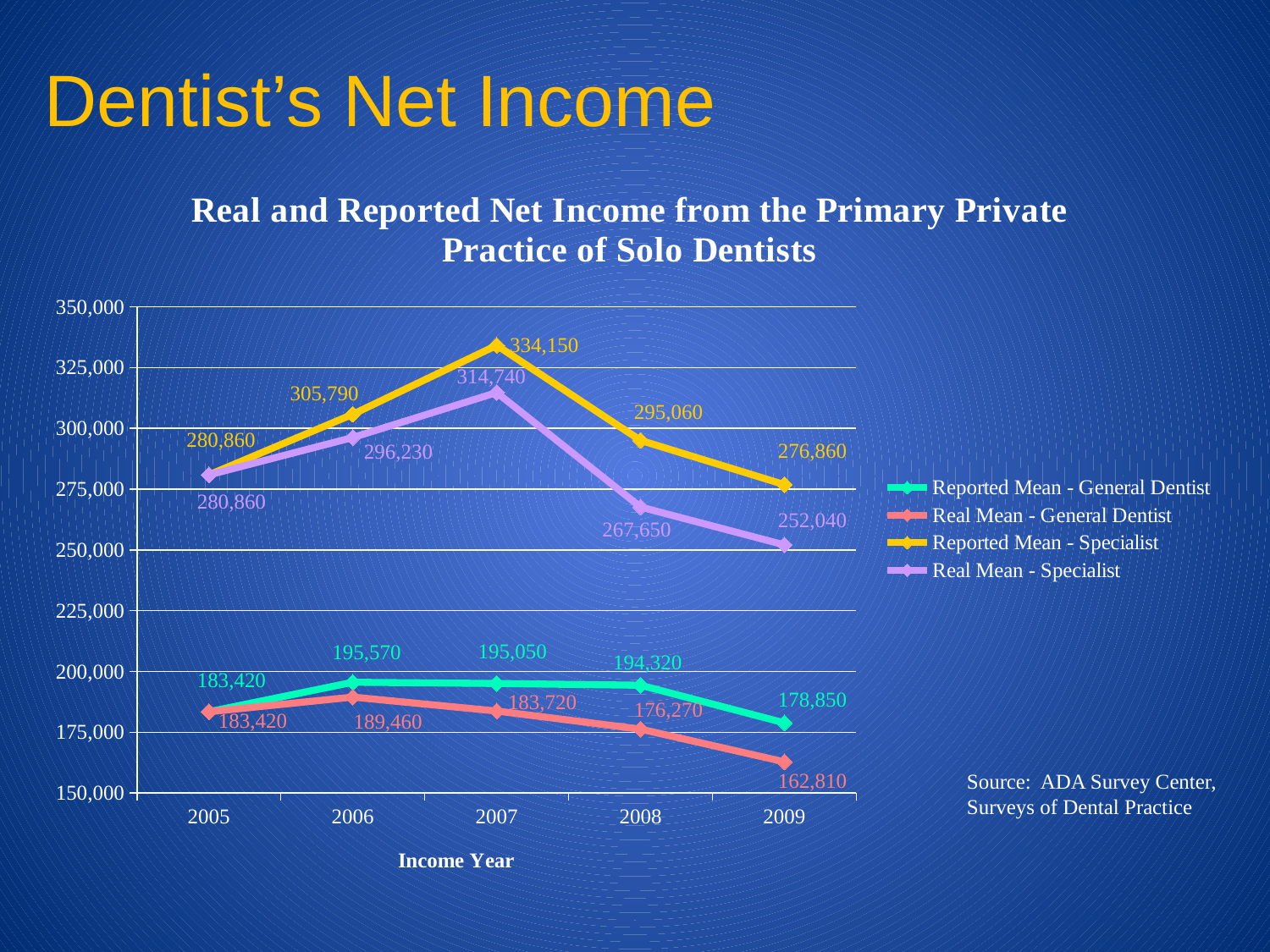
How many series does the legend list? 4 In 2008, which is larger: the Reported Mean - General Dentist or the Real Mean - General Dentist net income? Reported Mean - General Dentist In which year is the Real Mean - Specialist net income lowest? 2009 What kind of chart is shown on the slide? line chart How many income years are shown on the x axis? 5 What is the Real Mean - Specialist net income for 2006? 296,230 What is the difference between the Reported Mean - General Dentist and the Real Mean - General Dentist net income in 2009? 16,040 What is the Real Mean - General Dentist net income for 2009? 162,810 Is the Real Mean - Specialist net income for 2008 greater or less than 275,000? less What is the Reported Mean - Specialist net income for 2007? 334,150 In which year is the Reported Mean - Specialist net income highest? 2007 What is the difference between the Reported Mean - Specialist net income in 2007 and in 2009? 57,290